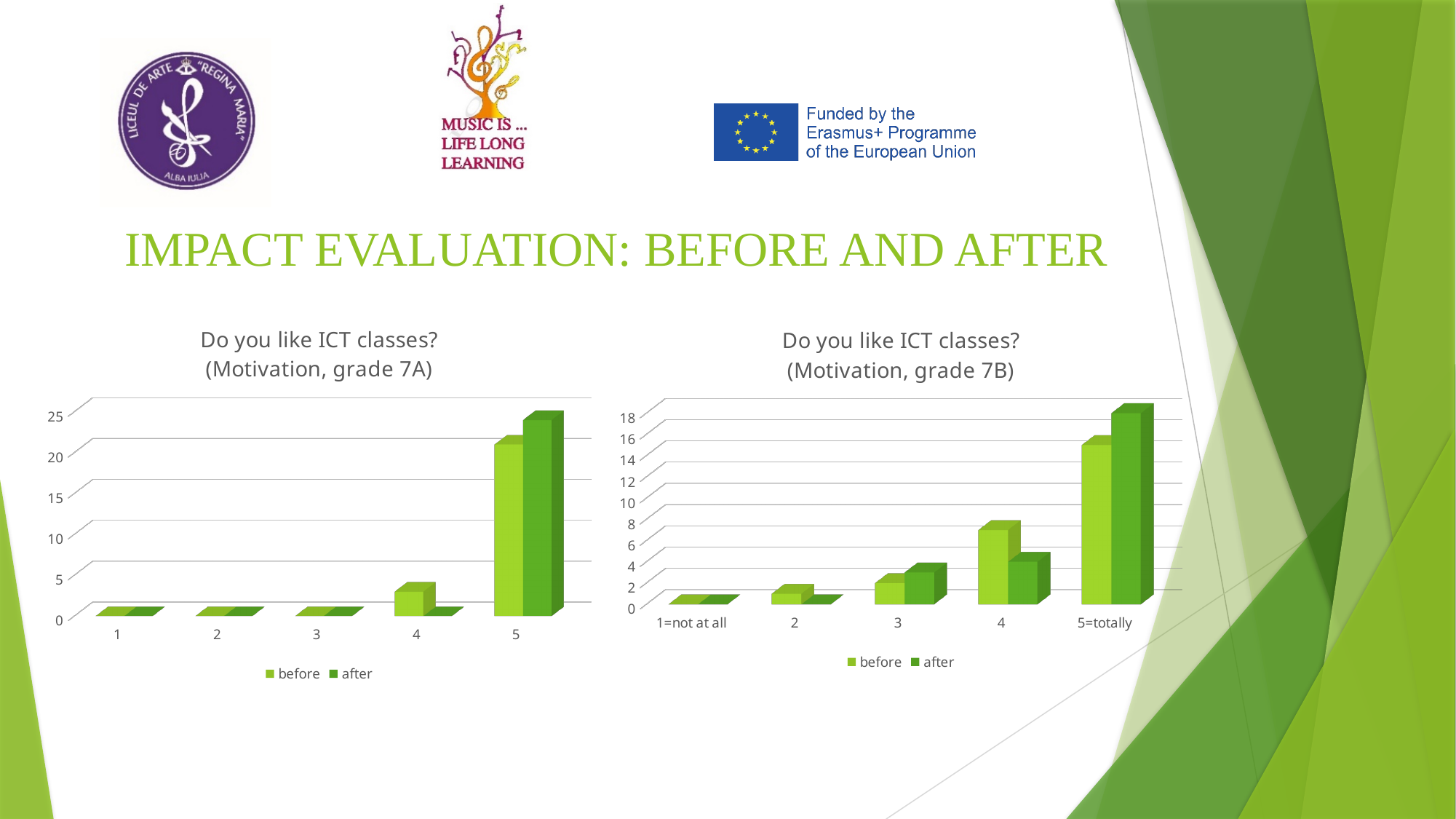
What kind of chart is the left chart titled "Do you like ICT classes? (Motivation, grade 7A)"? bar chart In the right chart (grade 7B), which category has the highest "after" value? 5=totally In the right chart (grade 7B), how many series does the legend list? 2 In the left chart (grade 7A), is the "after" value for category 5 greater or less than 20? greater What are the two legend entries in the left chart (grade 7A)? before, after In the right chart (grade 7B), for category 4, which is larger: the "before" value or the "after" value? before In the right chart (grade 7B), for "5=totally", which is larger: the "before" value or the "after" value? after In the left chart (grade 7A), how many categories are shown on the x axis? 5 In the right chart (grade 7B), is the "before" value for "5=totally" greater or less than 10? greater In the left chart (grade 7A), is the "before" value for category 4 greater or less than 5? less In the left chart (grade 7A), which category has the highest "before" value? 5